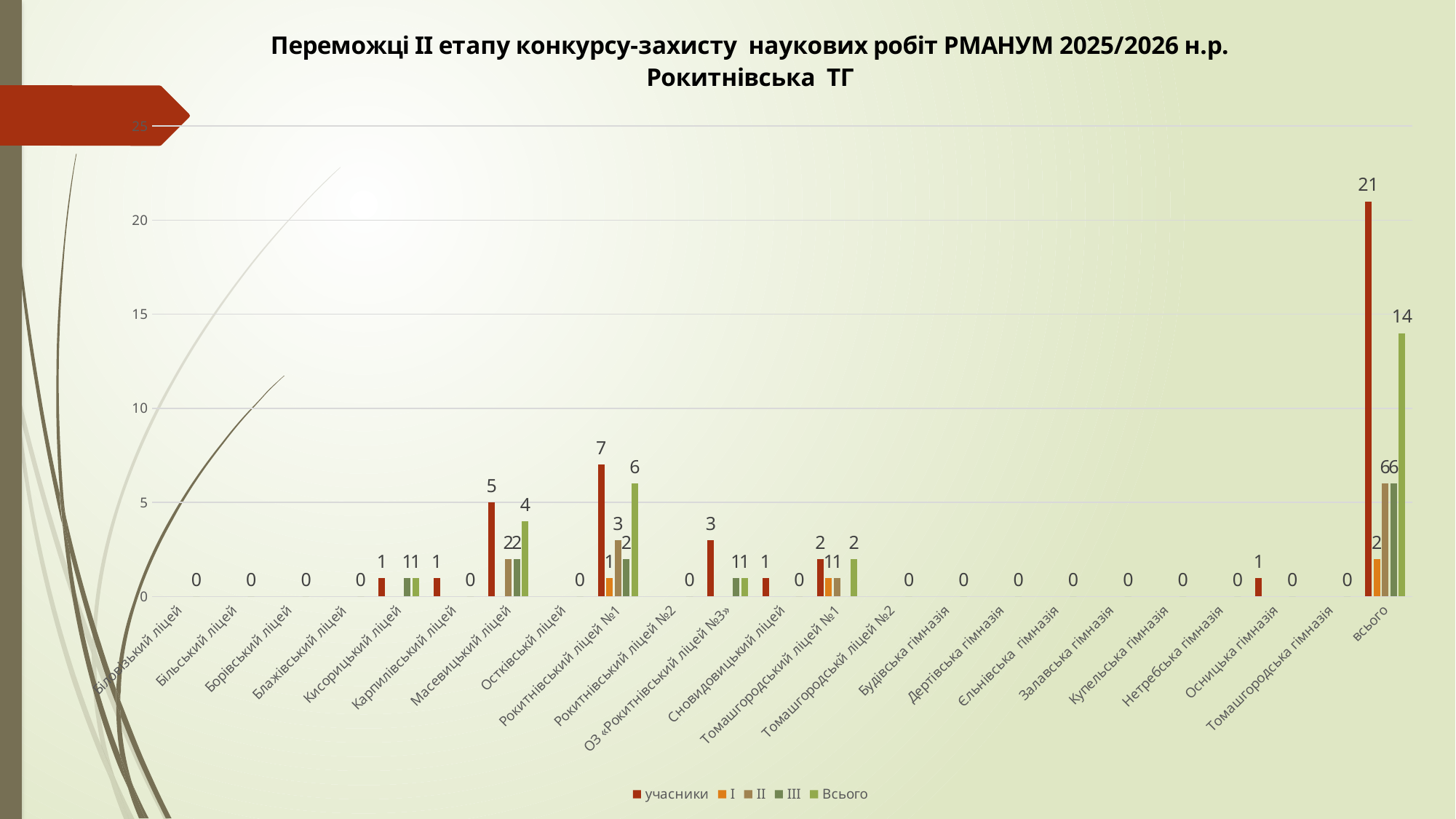
Which has a larger value of учасники: Масевицький ліцей or ОЗ «Рокитнівський ліцей №3»? Масевицький ліцей What is the value of учасники for всього? 21 What is the value of учасники for Рокитнівський ліцей №1? 7 What is the difference between учасники and Всього for the всього category? 7 How many series does the legend list? 5 What kind of chart is shown on the slide? bar chart What is the value of Всього for the всього category? 14 Is the value of учасники for всього greater or less than 20? greater How many categories are shown on the x axis? 23 Excluding the всього category, which school has the highest value of учасники? Рокитнівський ліцей №1 What is the value of II for Рокитнівський ліцей №1? 3 What is the value of Всього for Масевицький ліцей? 4